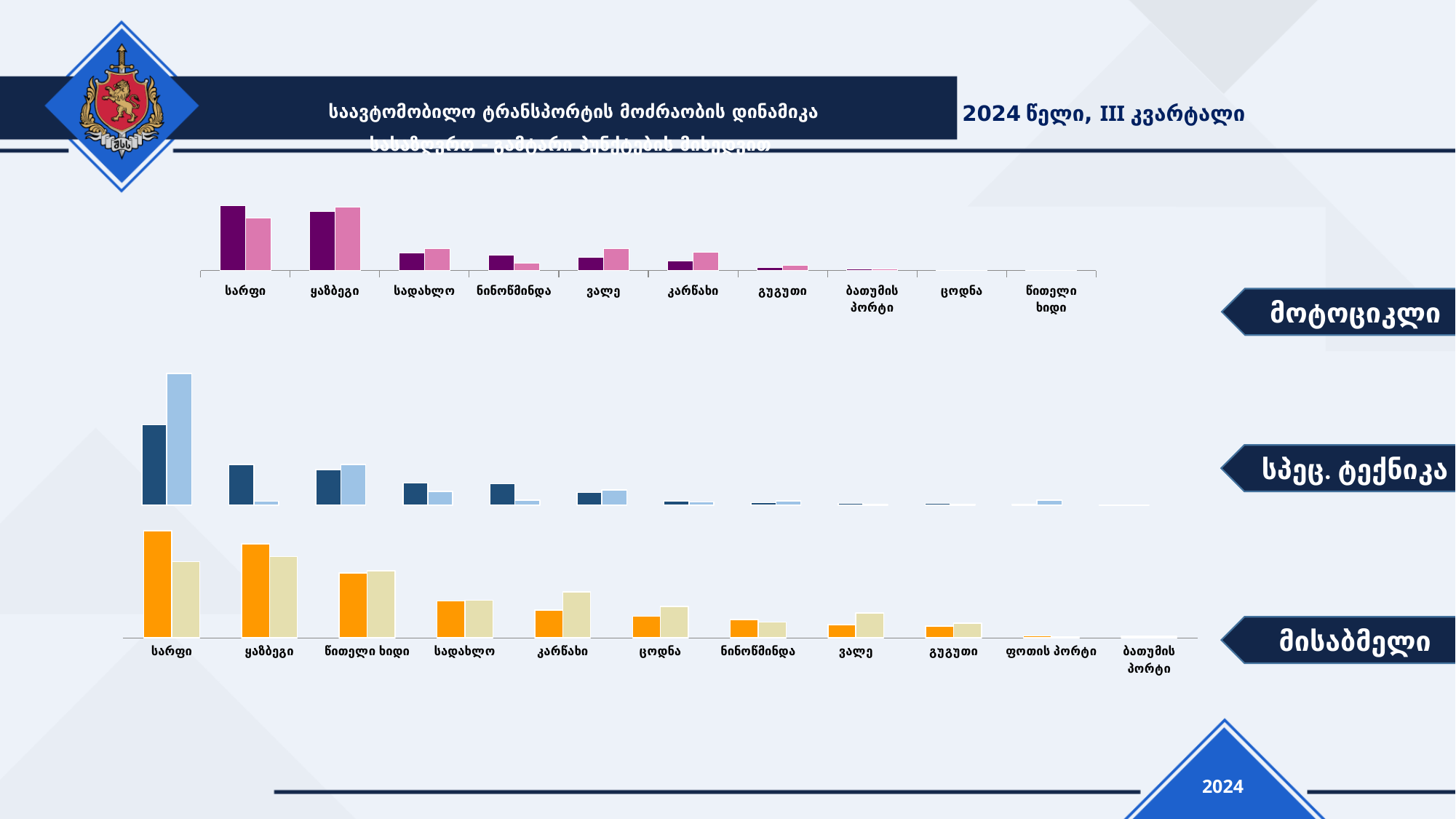
What two colours are used for the bars in the მისაბმელი chart? orange and beige In the მოტოციკლი chart, which is larger for the dark purple series: სარფი or სადახლო? სარფი In the მოტოციკლი chart, which is larger for the pink series: ყაზბეგი or კარწახი? ყაზბეგი In the მისაბმელი chart, which category has the highest value for the orange series? სარფი Do the values in the მოტოციკლი chart generally rise or fall from left to right along the x axis? fall In the მისაბმელი chart, which is larger for the orange series: ყაზბეგი or ვალე? ყაზბეგი Do the orange bars in the მისაბმელი chart generally rise or fall from left to right? fall What kind of chart is the მოტოციკლი chart at the top of the slide? bar chart How many categories are shown on the x axis of the მოტოციკლი chart? 10 How many categories are shown on the x axis of the მისაბმელი chart at the bottom of the slide? 11 How many bars are plotted per category in the სპეც. ტექნიკა chart in the middle of the slide? 2